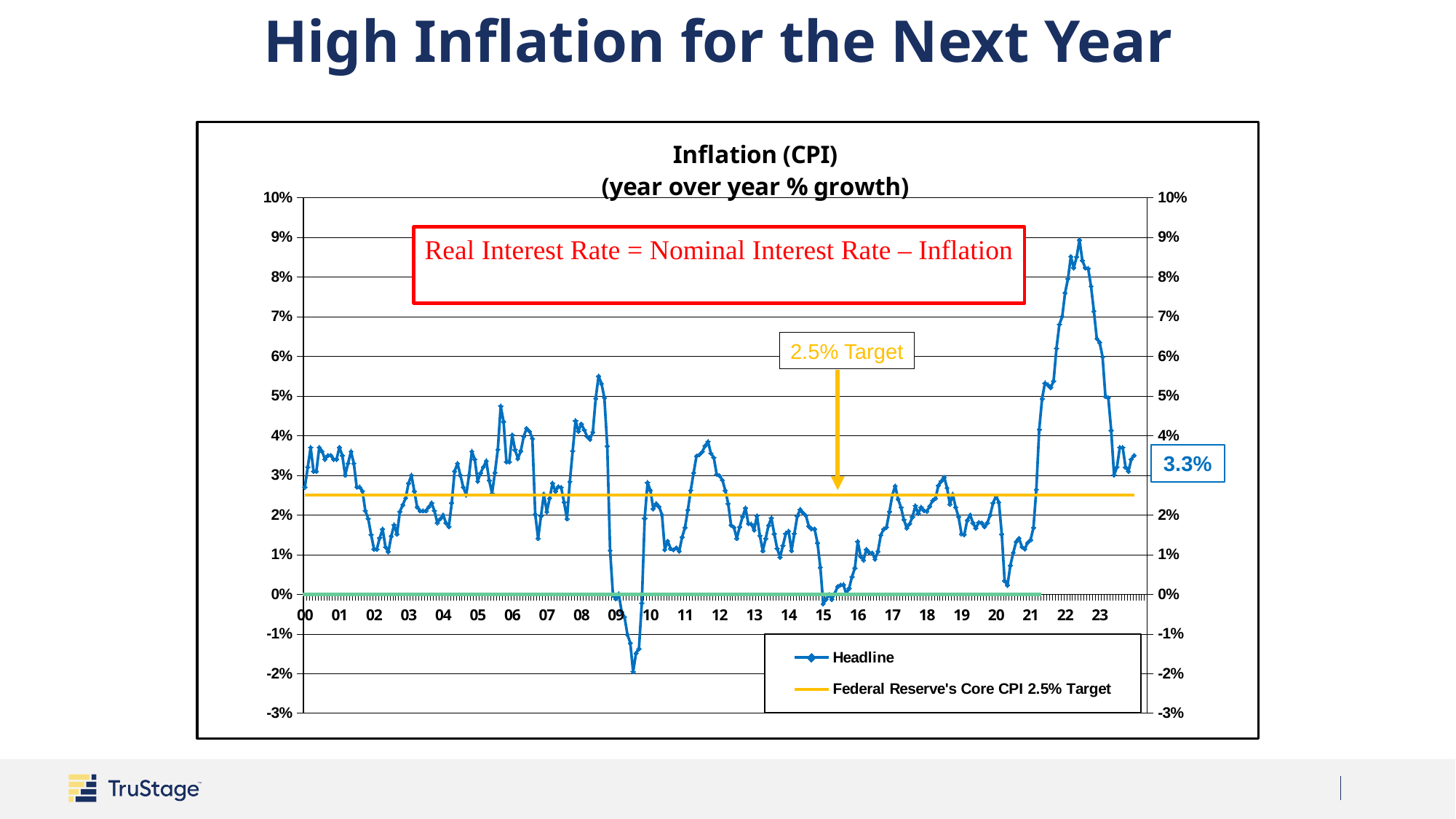
Is the peak Headline inflation value in 2022 greater or less than 8%? greater Is the lowest Headline inflation value in 2009 greater or less than -1%? less What kind of chart is shown on the slide? line chart What is the most recent Headline inflation value labeled on the chart? 3.3% What is the title of the chart? Inflation (CPI) (year over year % growth) Does Headline inflation rise or fall from its 2022 peak to 2023? fall How many series does the chart legend list? 2 In which year on the x axis does Headline inflation reach its lowest point? 09 In which year on the x axis does Headline inflation reach its highest point? 22 How many year labels are shown on the x axis? 24 What value is the Federal Reserve's Core CPI target line set at? 2.5% Is the latest Headline value of 3.3% above or below the 2.5% target line? above